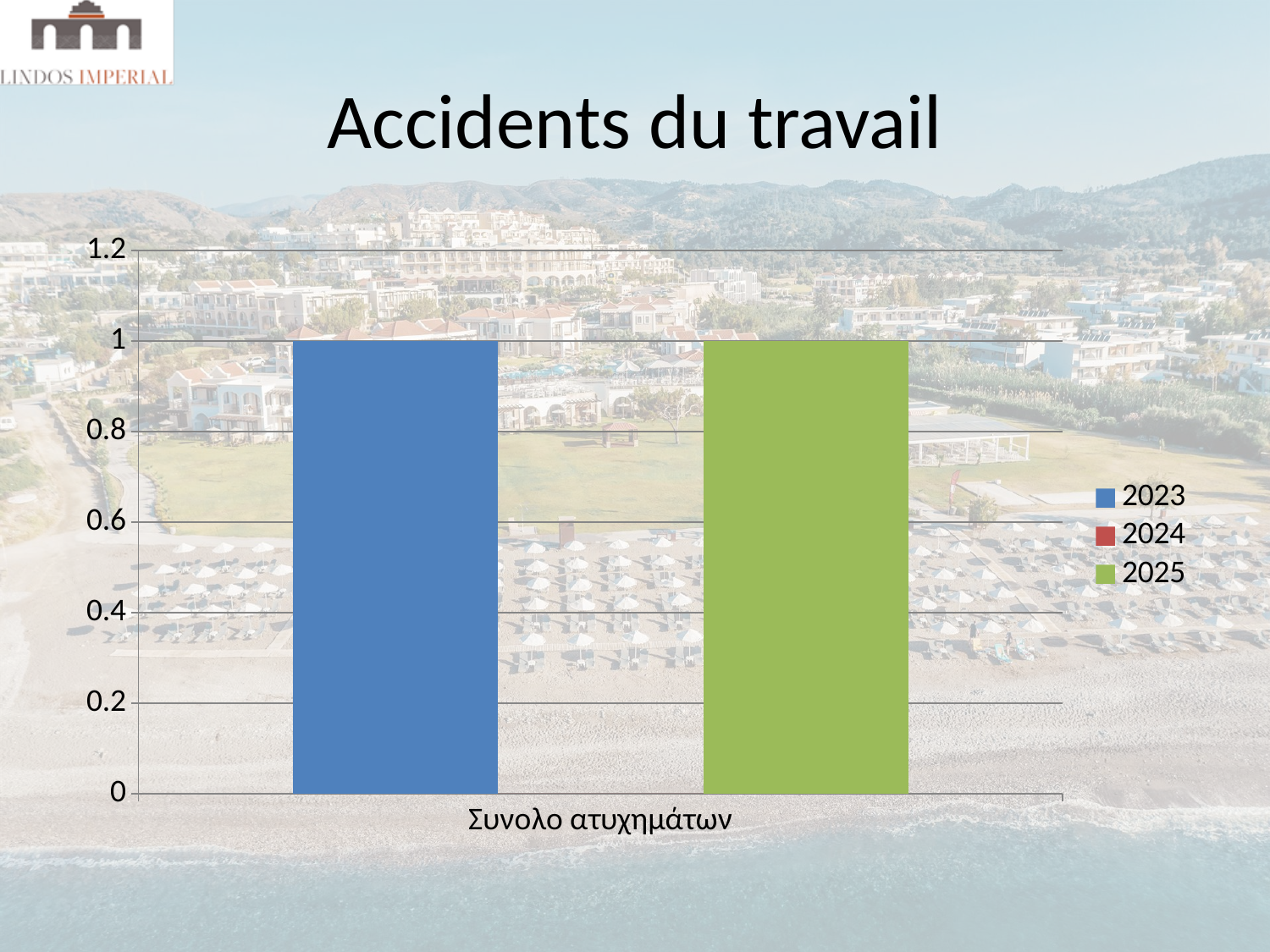
Which colour represents the 2025 series in the legend? green What kind of chart is shown on the slide? bar chart What is the title of the chart on the slide? Accidents du travail What is the value of the 2025 bar for Σύνολο ατυχημάτων? 1 Is the value for 2023 greater or less than 0.6? greater What is the value of the 2023 bar for Σύνολο ατυχημάτων? 1 How many series does the legend list? 3 Is the value for 2025 greater or less than 1.2? less How many categories are shown on the x axis? 1 What is the difference between the 2023 and 2025 values for Σύνολο ατυχημάτων? 0 What is the label of the category on the x axis? Συνολο ατυχημάτων